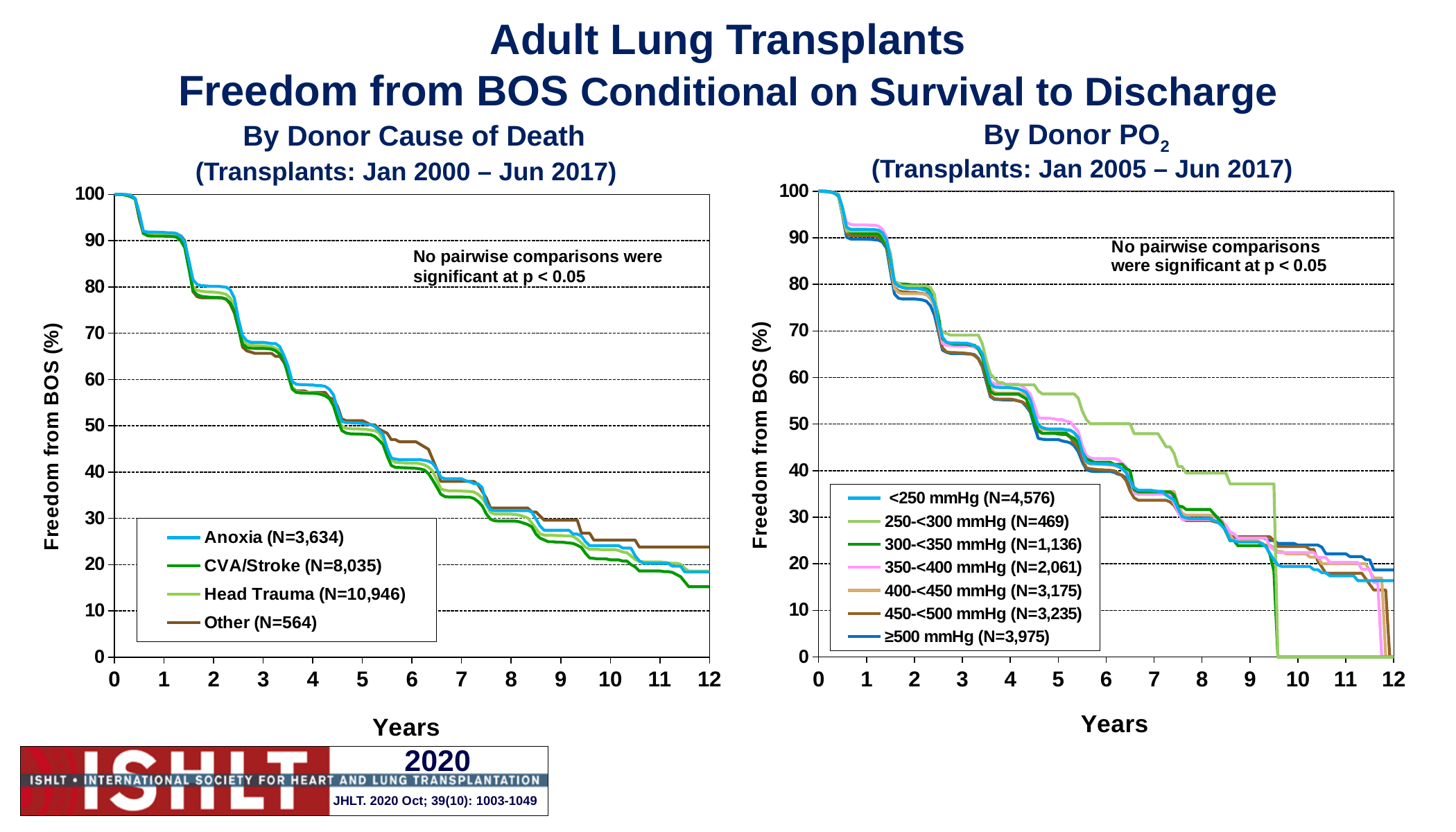
How many series does the legend of the 'By Donor PO2' chart list? 7 What kind of chart is the 'By Donor Cause of Death' chart on the left? line chart In the 'By Donor Cause of Death' chart, is the value for Other at year 6 greater or less than 50? less What is the y-axis label of the 'By Donor PO2' chart? Freedom from BOS (%) In the 'By Donor PO2' chart, which series has the highest value at year 9? 250-<300 mmHg (N=469) In the 'By Donor Cause of Death' chart, which is larger at year 11: Other or CVA/Stroke? Other In the 'By Donor Cause of Death' chart, is the value for Other at year 12 greater or less than 20? greater In the 'By Donor PO2' chart, is the value for 250-<300 mmHg at year 8 greater or less than 30? greater What is the N shown in the legend for Head Trauma in the 'By Donor Cause of Death' chart? N=10,946 How many series does the legend of the 'By Donor Cause of Death' chart list? 4 In the 'By Donor Cause of Death' chart, do the values rise or fall as years increase? fall